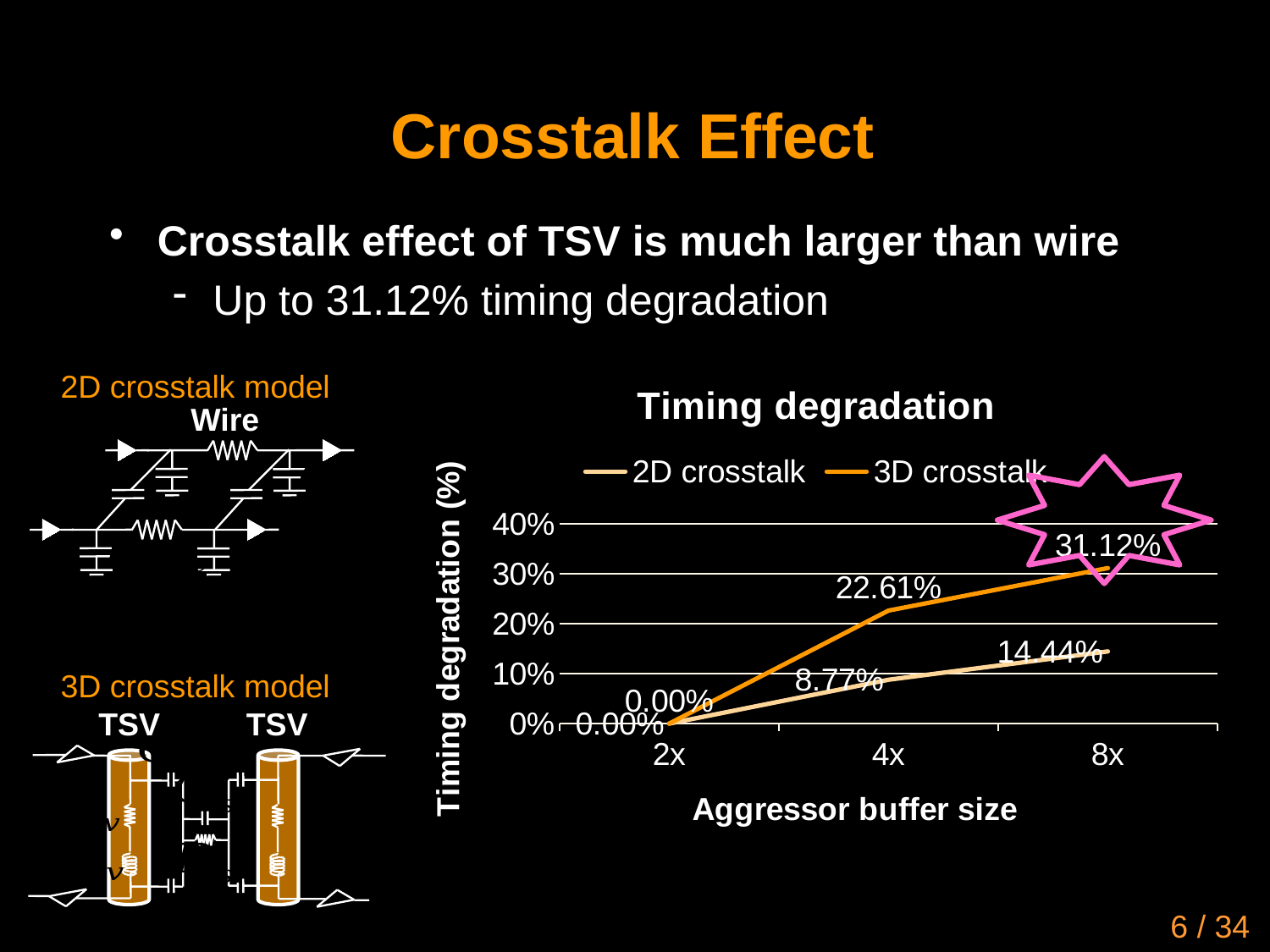
What is the timing degradation for 2D crosstalk at an aggressor buffer size of 8x? 14.44% What is the timing degradation for 2D crosstalk at an aggressor buffer size of 4x? 8.77% What is the difference between the 3D crosstalk and 2D crosstalk timing degradation at 8x? 16.68% Does the 2D crosstalk timing degradation rise or fall as the aggressor buffer size increases from 2x to 8x? rise At 4x aggressor buffer size, which series has the larger timing degradation, 2D crosstalk or 3D crosstalk? 3D crosstalk How many aggressor buffer sizes are plotted on the x axis of the "Timing degradation" chart? 3 What is the timing degradation for 3D crosstalk at an aggressor buffer size of 8x? 31.12% What type of chart is shown under the title "Timing degradation"? line chart How many series does the legend of the "Timing degradation" chart list? 2 Is the 3D crosstalk timing degradation at 8x greater or less than 30%? greater What is the timing degradation for 3D crosstalk at an aggressor buffer size of 4x? 22.61% At which aggressor buffer size is the 3D crosstalk timing degradation highest? 8x